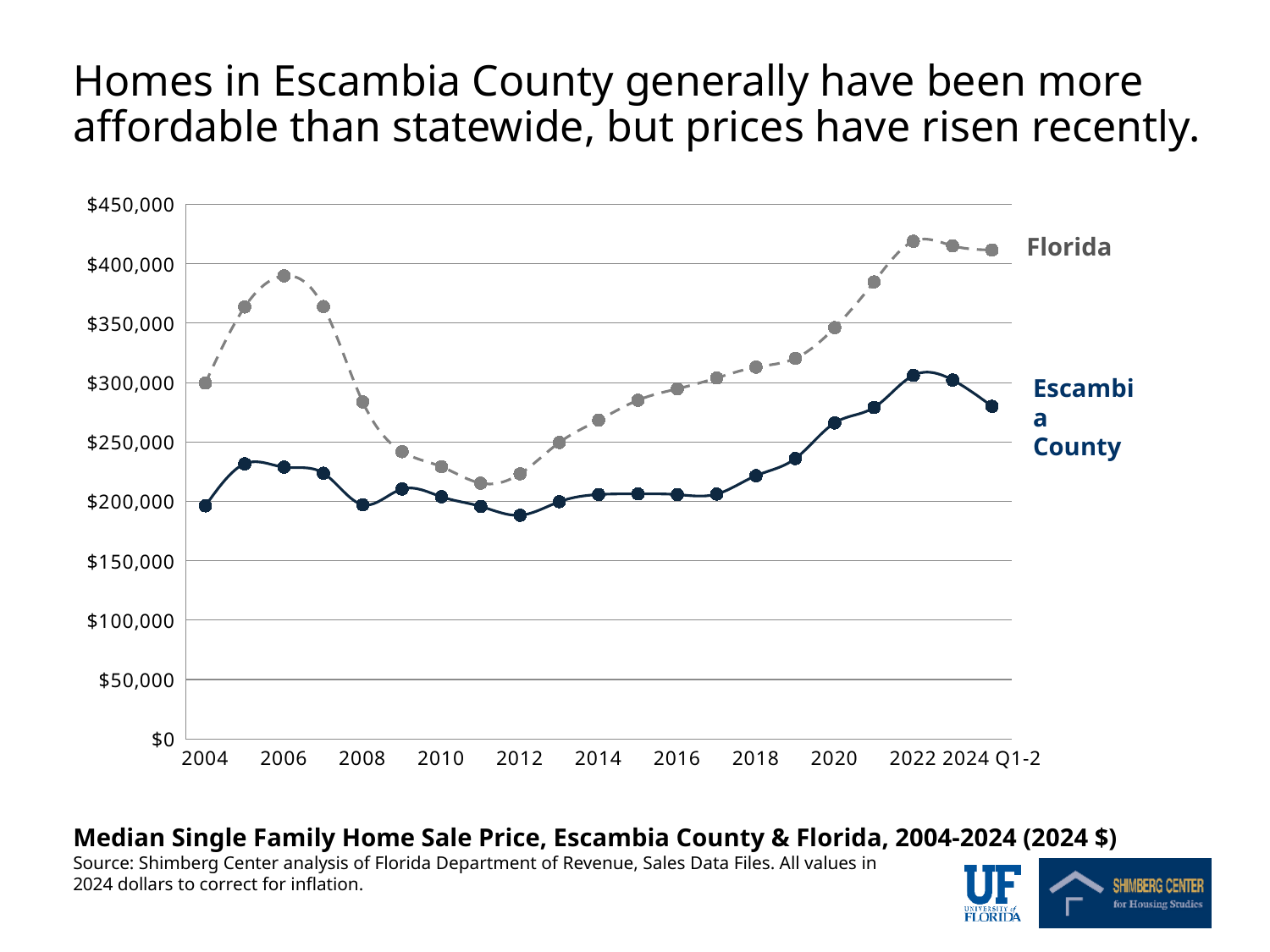
Is the Florida value for 2006 greater or less than $350,000? greater Does the Escambia County series rise or fall between 2017 and 2022? rise Is the Florida value for 2011 greater or less than $250,000? less In which year does the Escambia County series reach its lowest value? 2012 Is the Escambia County value for 2012 greater or less than $200,000? less How many data points does the Florida series have? 21 How many series are plotted on the chart? 2 Which series has the higher value in 2006, Florida or Escambia County? Florida What kind of chart is shown on the slide? line chart Which series is drawn with a dashed line? Florida In which year does the Florida series reach its highest value? 2022